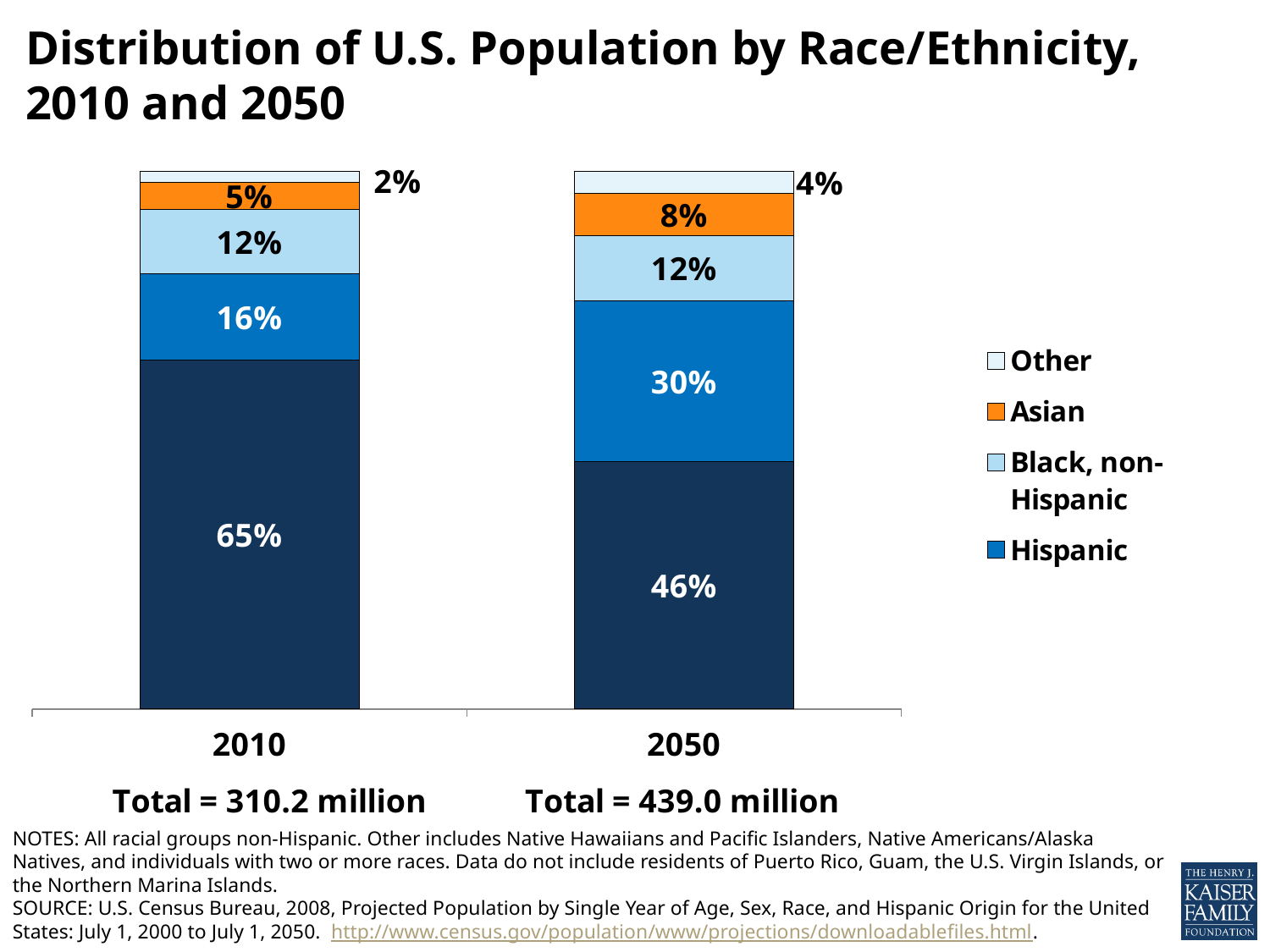
What is the Hispanic share of the U.S. population in 2050? 30% What kind of chart is shown on the slide? Stacked bar chart What total U.S. population is given for 2050? 439.0 million What is the Black, non-Hispanic share of the U.S. population in 2050? 12% How many years (bars) are shown on the chart? 2 What is the 'Other' share of the U.S. population in 2010? 2% By how many percentage points does the Hispanic share increase from 2010 to 2050? 14 percentage points How many entries does the legend list? 4 Is the Asian share larger in 2010 or in 2050? 2050 What is the Hispanic share of the U.S. population in 2010? 16% What is the Asian share of the U.S. population in 2050? 8% Does the Hispanic share rise or fall from 2010 to 2050? Rises